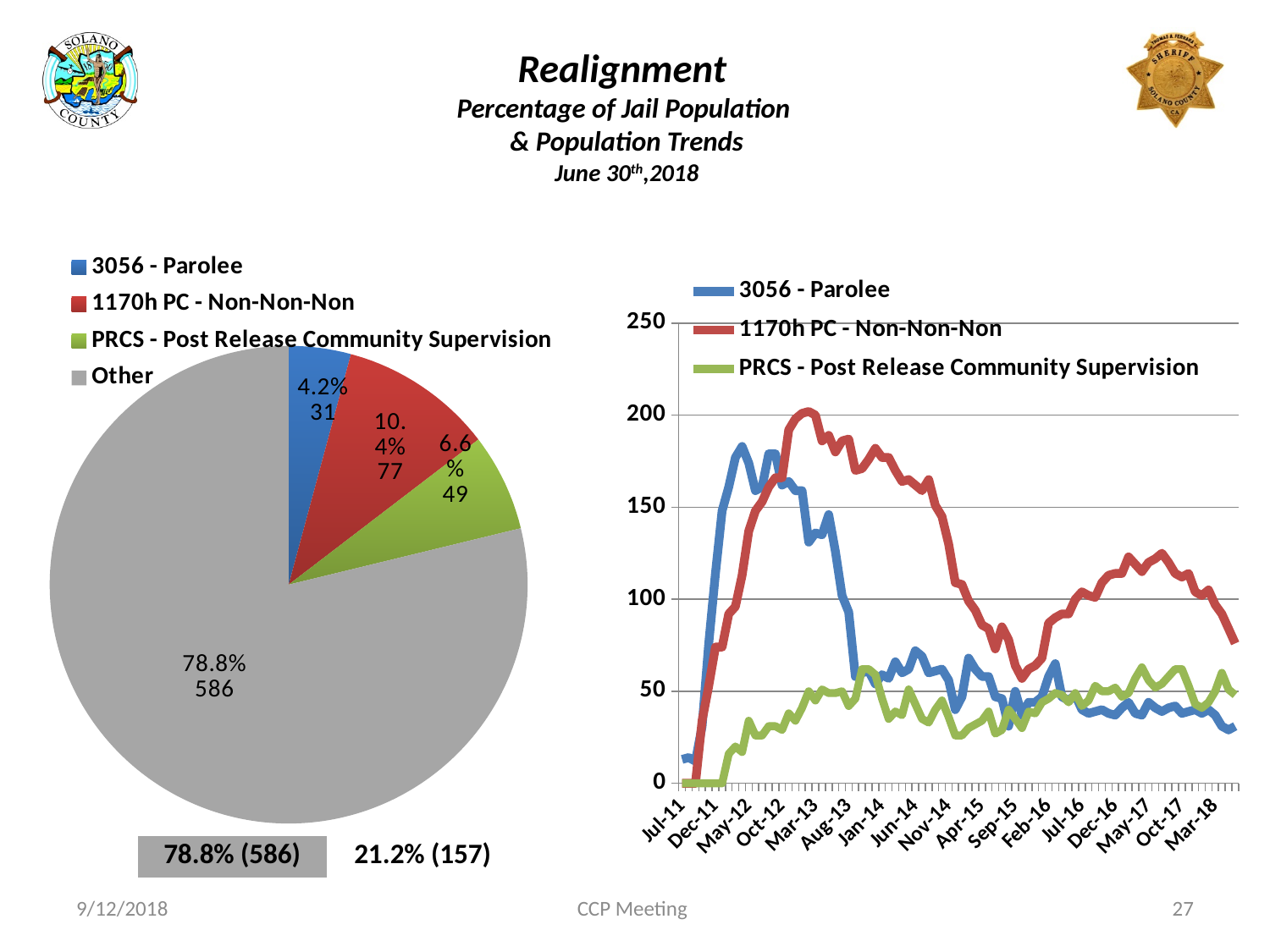
On the line chart on the right, which series has the highest peak value over the whole period? 1170h PC - Non-Non-Non What kind of chart is the chart on the right of the slide? Line chart On the pie chart on the left, how many people are in the 1170h PC - Non-Non-Non slice? 77 On the pie chart on the left, what percentage of the jail population is labelled as Other? 78.8% On the pie chart on the left, what percentage is shown for PRCS - Post Release Community Supervision? 6.6% On the line chart on the right, is the value for 1170h PC - Non-Non-Non at Mar-13 greater or less than 150? greater On the pie chart on the left, which category has the smallest slice? 3056 - Parolee On the pie chart on the left, what count is shown for 3056 - Parolee? 31 On the pie chart on the left, how many categories does the legend list? 4 On the pie chart on the left, which category has the largest slice? Other On the pie chart on the left, what is the difference in count between the 1170h PC - Non-Non-Non slice and the PRCS - Post Release Community Supervision slice? 28 On the line chart on the right, how many series does the legend list? 3